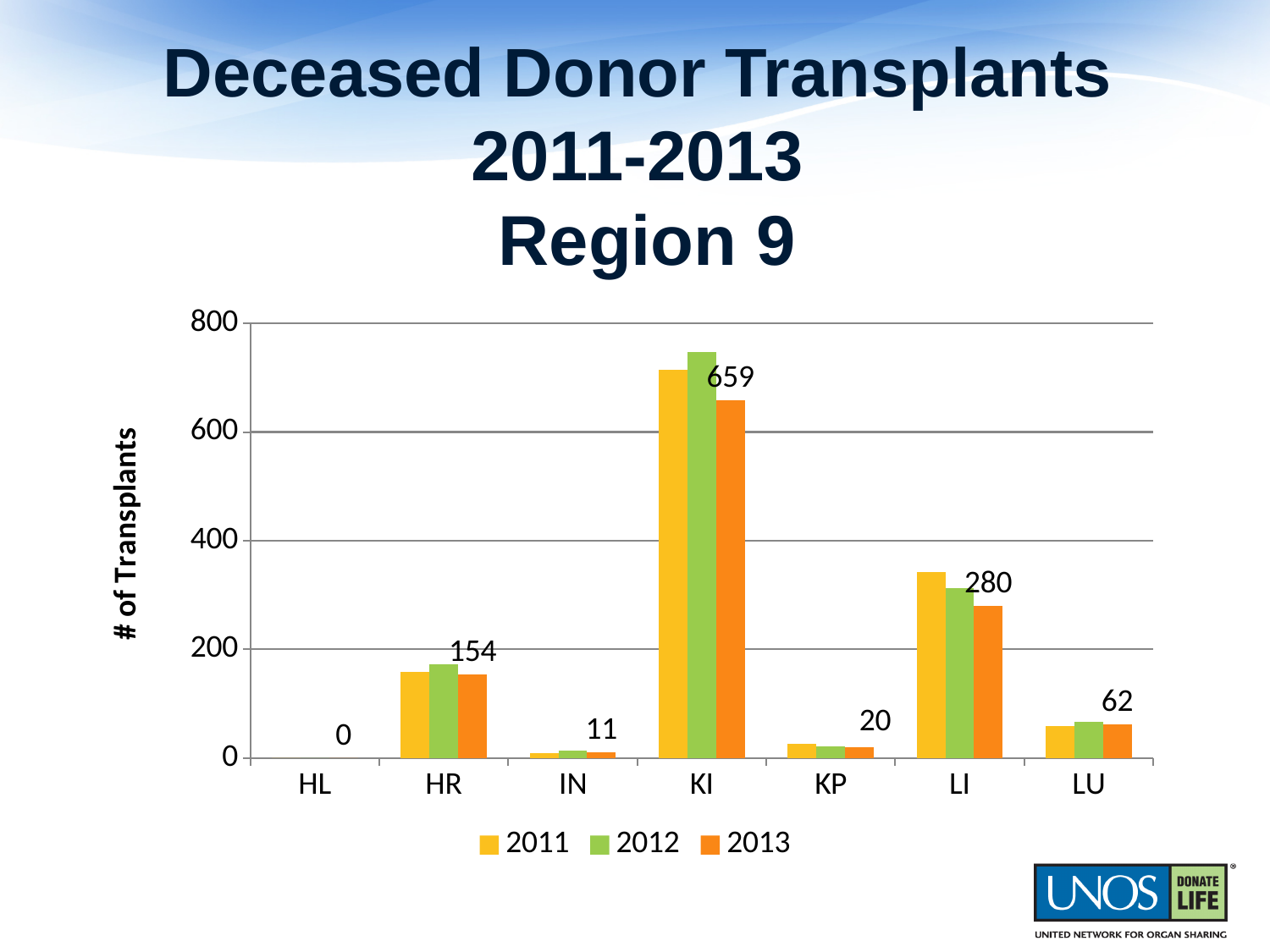
What is the difference between the 2013 values for KI and LI? 379 What kind of chart is shown on the slide? bar chart How many categories are shown on the x axis? 7 Which is larger in 2013, KP or IN? KP Is the value for KI in 2012 greater or less than 600? greater How many series does the legend list? 3 What is the value for HR in 2013? 154 What is the value for LU in 2013? 62 Which category has the highest number of transplants in 2013? KI What is the value for LI in 2013? 280 What is the value for KI in 2013? 659 Which category has the lowest number of transplants in 2013? HL